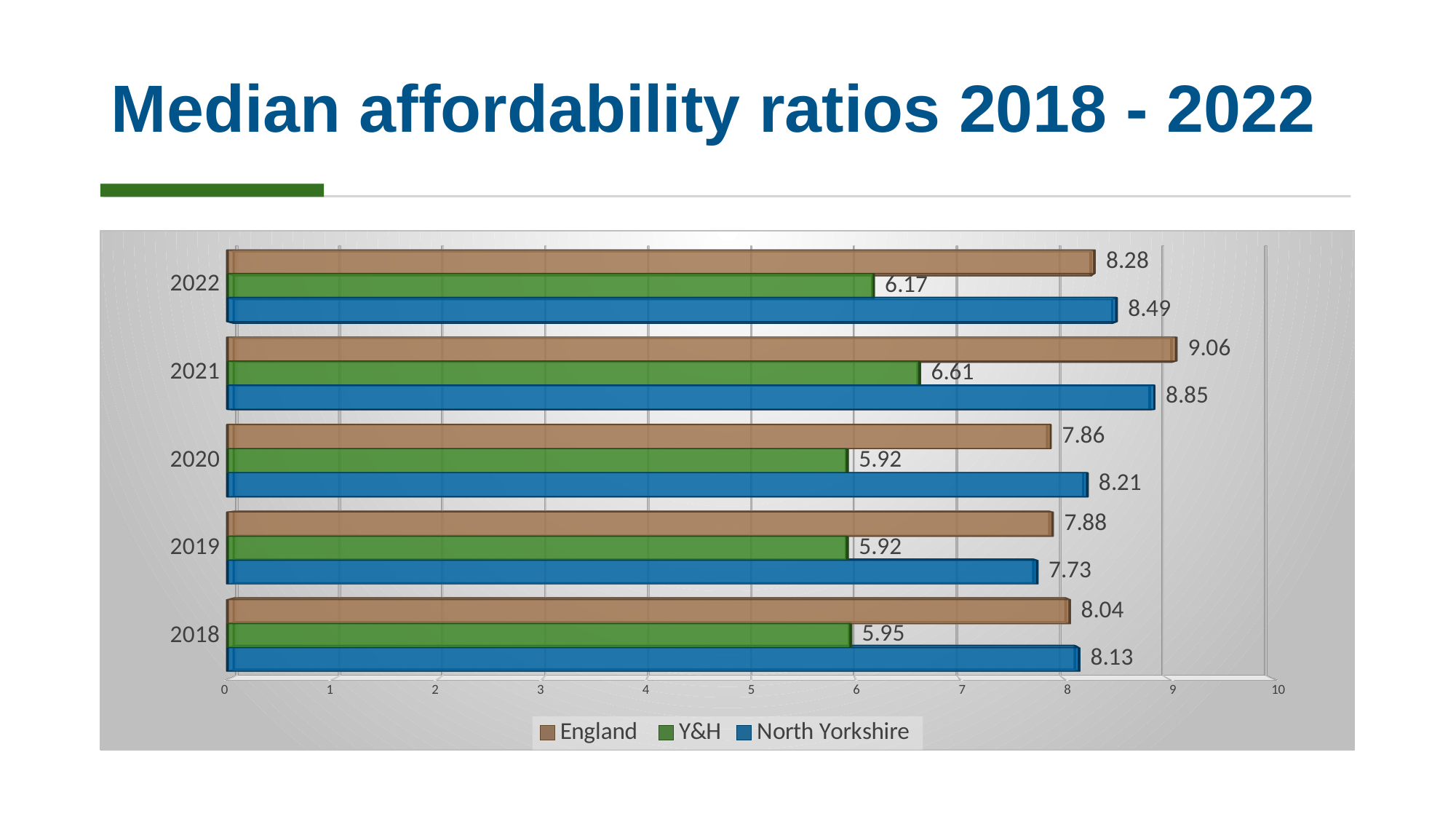
What is the median affordability ratio for England in 2021? 9.06 In which year is the North Yorkshire median affordability ratio lowest? 2019 How many years are shown on the chart? 5 What kind of chart is shown on the slide? bar chart Which colour represents North Yorkshire in the chart? blue Which is larger in 2019, the England ratio or the North Yorkshire ratio? England In which year is the England median affordability ratio highest? 2021 What is the difference between the North Yorkshire and Y&H ratios in 2021? 2.24 What is the median affordability ratio for Y&H in 2018? 5.95 How many series does the legend list? 3 What is the median affordability ratio for North Yorkshire in 2022? 8.49 Is the value for Y&H in 2020 greater or less than 6? less